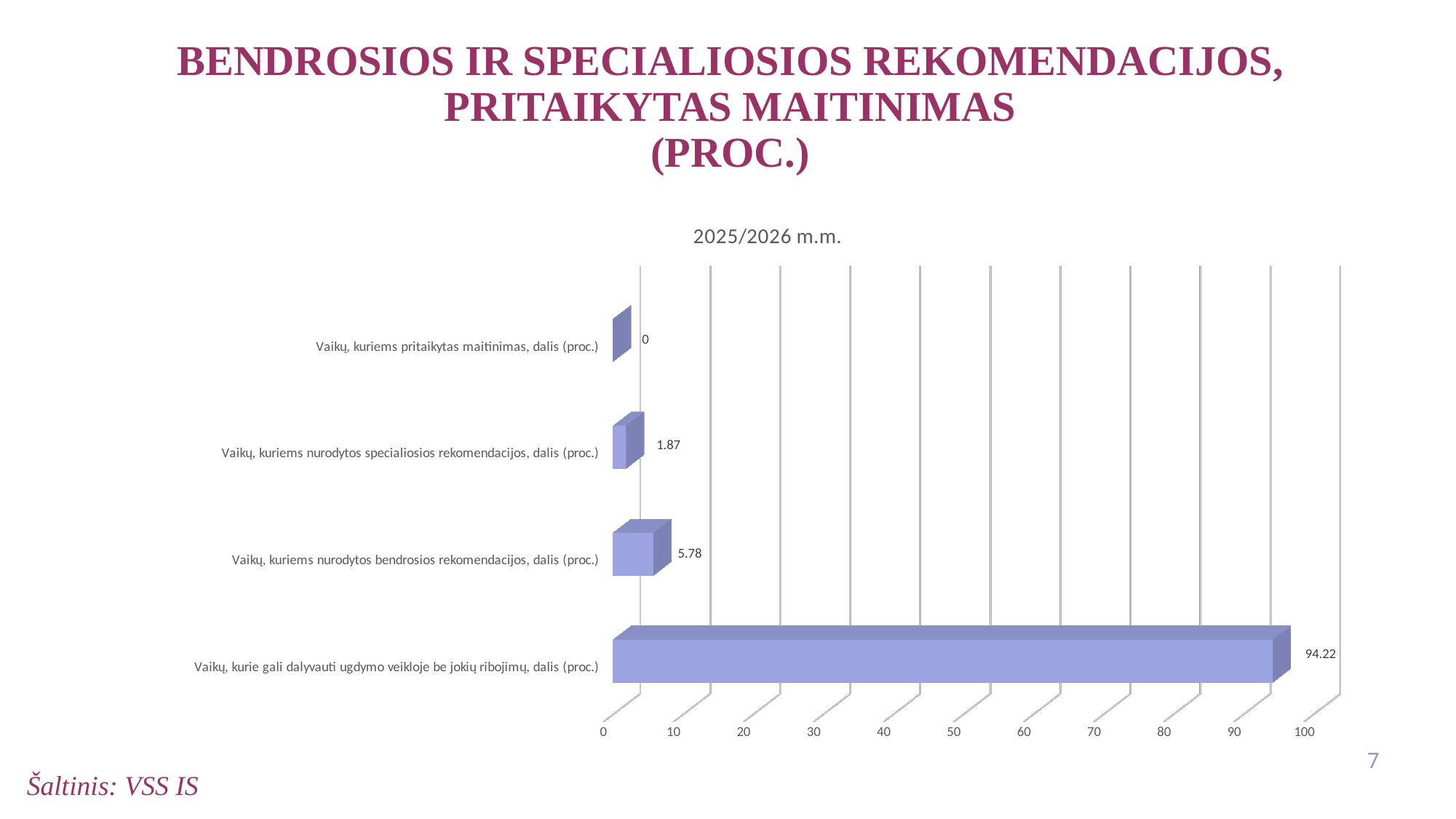
Is the value for "Vaikų, kurie gali dalyvauti ugdymo veikloje be jokių ribojimų, dalis (proc.)" greater or less than 90? greater What is the value for "Vaikų, kuriems nurodytos specialiosios rekomendacijos, dalis (proc.)"? 1.87 How many categories are shown in the chart? 4 What is the title of the chart? 2025/2026 m.m. What kind of chart is shown on the slide? bar chart What is the value for "Vaikų, kuriems pritaikytas maitinimas, dalis (proc.)"? 0 Which is larger: the value for bendrosios rekomendacijos or the value for specialiosios rekomendacijos? Vaikų, kuriems nurodytos bendrosios rekomendacijos, dalis (proc.) Which category has the highest value? Vaikų, kurie gali dalyvauti ugdymo veikloje be jokių ribojimų, dalis (proc.) What is the difference between the values for bendrosios rekomendacijos and specialiosios rekomendacijos? 3.91 What is the value for "Vaikų, kuriems nurodytos bendrosios rekomendacijos, dalis (proc.)"? 5.78 Which category has the lowest value? Vaikų, kuriems pritaikytas maitinimas, dalis (proc.) What is the value for "Vaikų, kurie gali dalyvauti ugdymo veikloje be jokių ribojimų, dalis (proc.)"? 94.22